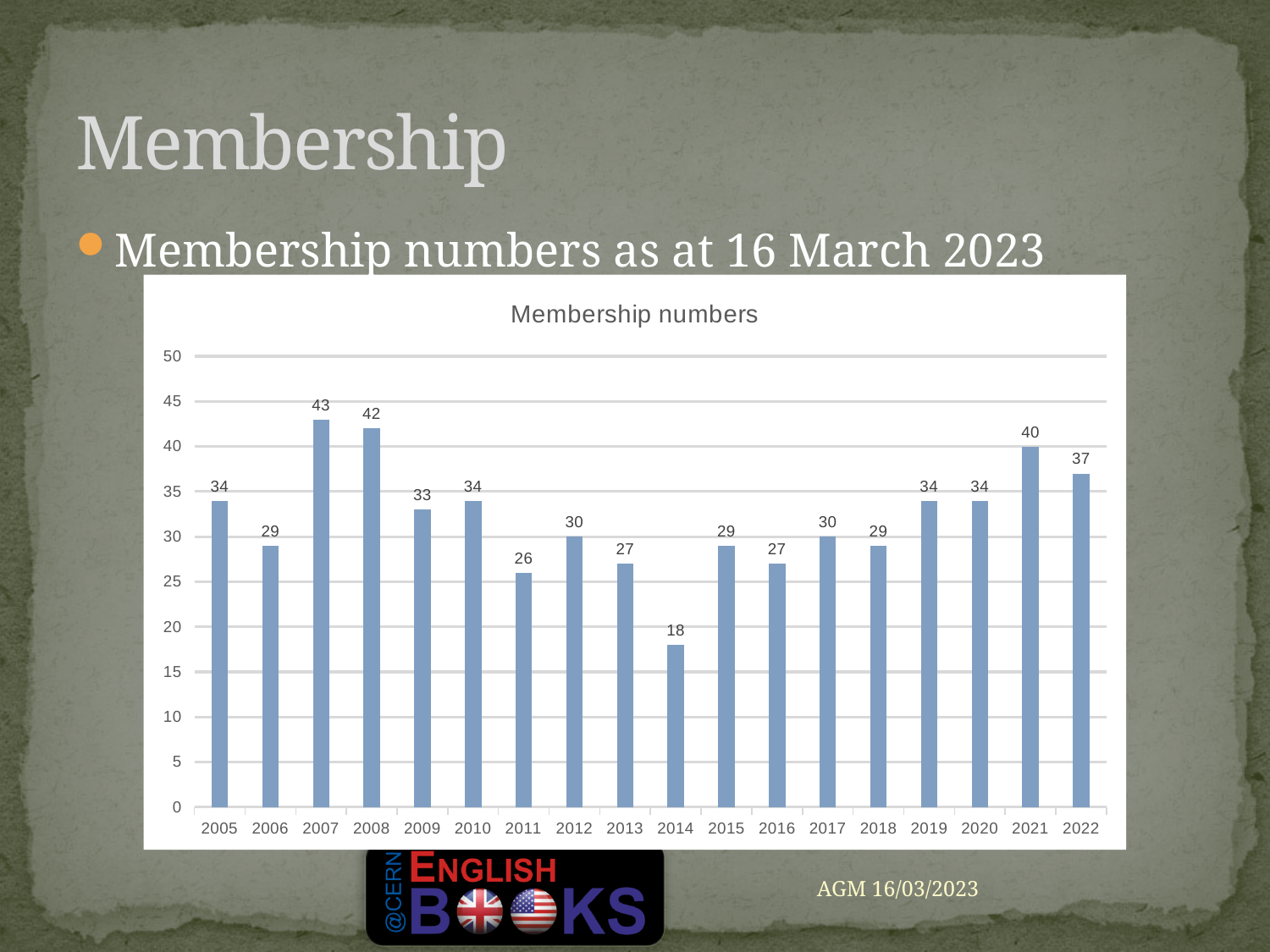
What kind of chart is shown on the slide? bar chart What is the difference between the membership numbers for 2021 and 2014? 22 Which year has the highest membership number? 2007 Is the membership number for 2011 greater or less than 30? less Which year has the larger membership number, 2008 or 2022? 2008 What is the membership number for 2022? 37 Which year has the lowest membership number? 2014 What is the title of the chart? Membership numbers How many years are shown on the x axis of the chart? 18 Do the membership numbers rise or fall from 2018 to 2021? rise What is the membership number for 2007? 43 What is the membership number for 2014? 18